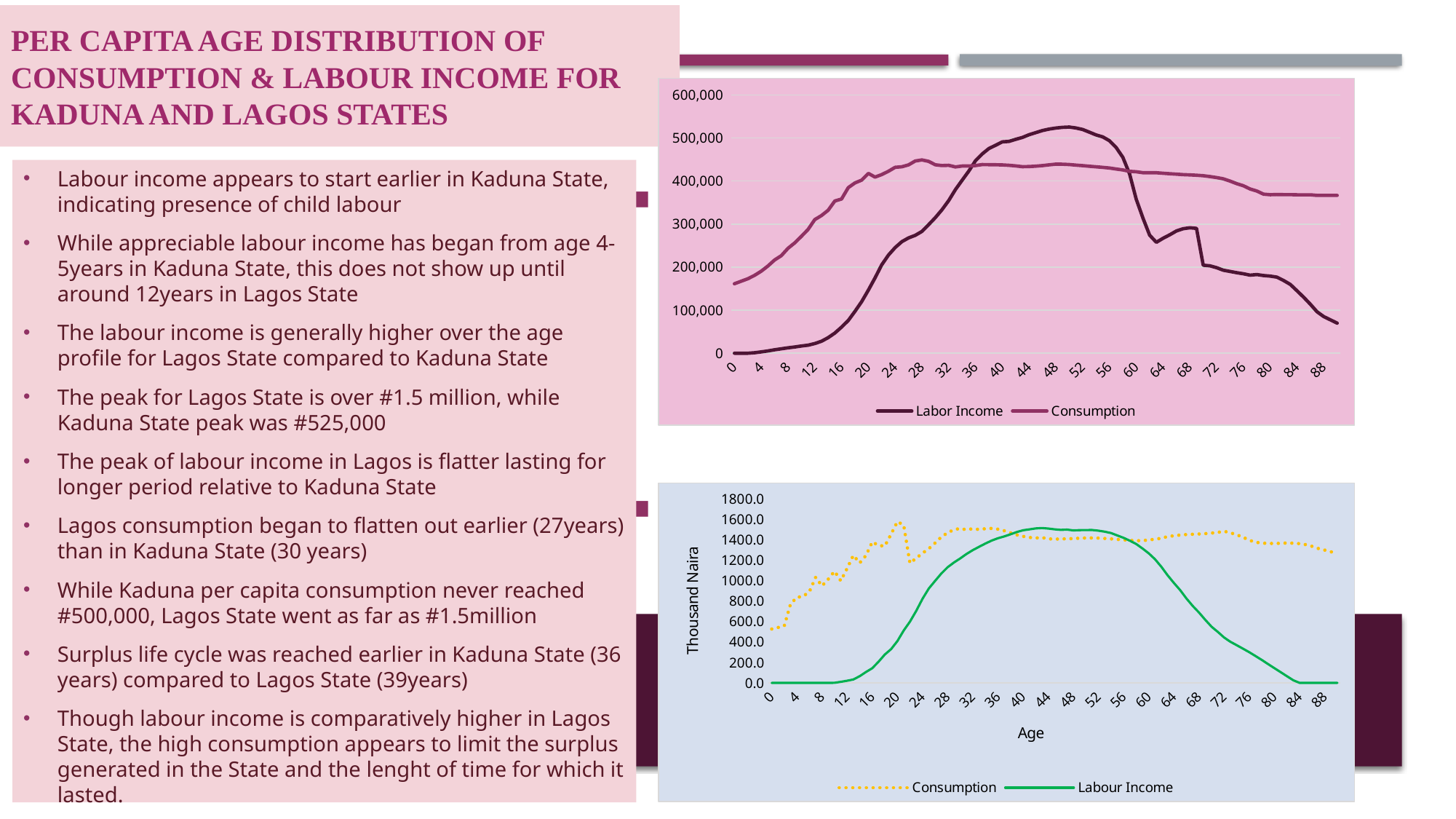
In the top chart, is the Labor Income value at age 0 greater or less than 100,000? less In the bottom chart, is the Labour Income value at age 88 greater or less than 200.0? less What is the y-axis label of the bottom chart? Thousand Naira In the top chart, at age 88, which series has the larger value, Labor Income or Consumption? Consumption What kind of chart is the top chart on the slide? line chart How many series does the legend of the top chart list? 2 In the top chart, is the Labor Income value at age 48 greater or less than 500,000? greater How many series does the legend of the bottom chart list? 2 In the top chart, does the Labor Income line rise or fall between age 60 and age 88? fall What is the x-axis label of the bottom chart? Age